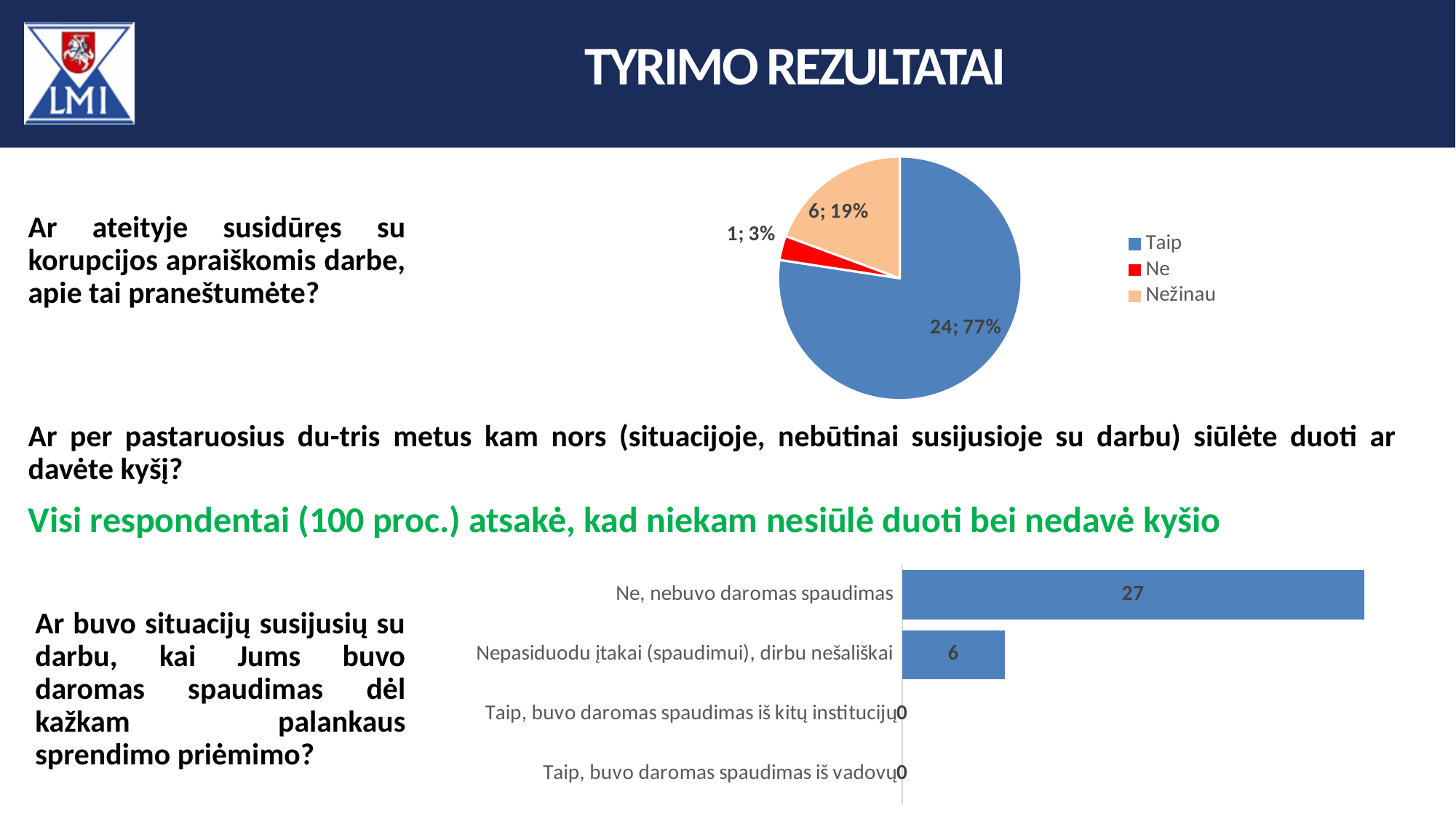
In the pie chart at the top of the slide, which category has the largest slice? Taip In the bar chart at the bottom of the slide, what is the value for "Nepasiduodu įtakai (spaudimui), dirbu nešališkai"? 6 How many entries does the legend of the pie chart at the top of the slide list? 3 In the pie chart at the top of the slide, what share of the pie does "Nežinau" take? 19% What kind of chart is at the bottom of the slide? Bar chart In the pie chart at the top of the slide, what is the difference in count between "Taip" and "Nežinau"? 18 In the bar chart at the bottom of the slide, what is the difference between "Ne, nebuvo daromas spaudimas" and "Nepasiduodu įtakai (spaudimui), dirbu nešališkai"? 21 In the pie chart at the top of the slide, what colour is the "Ne" slice? Red How many categories does the bar chart at the bottom of the slide show? 4 In the bar chart at the bottom of the slide, what is the value for "Ne, nebuvo daromas spaudimas"? 27 In the pie chart at the top of the slide, which category has the smallest slice? Ne In the pie chart at the top of the slide, what value is shown for the "Taip" slice? 24; 77%